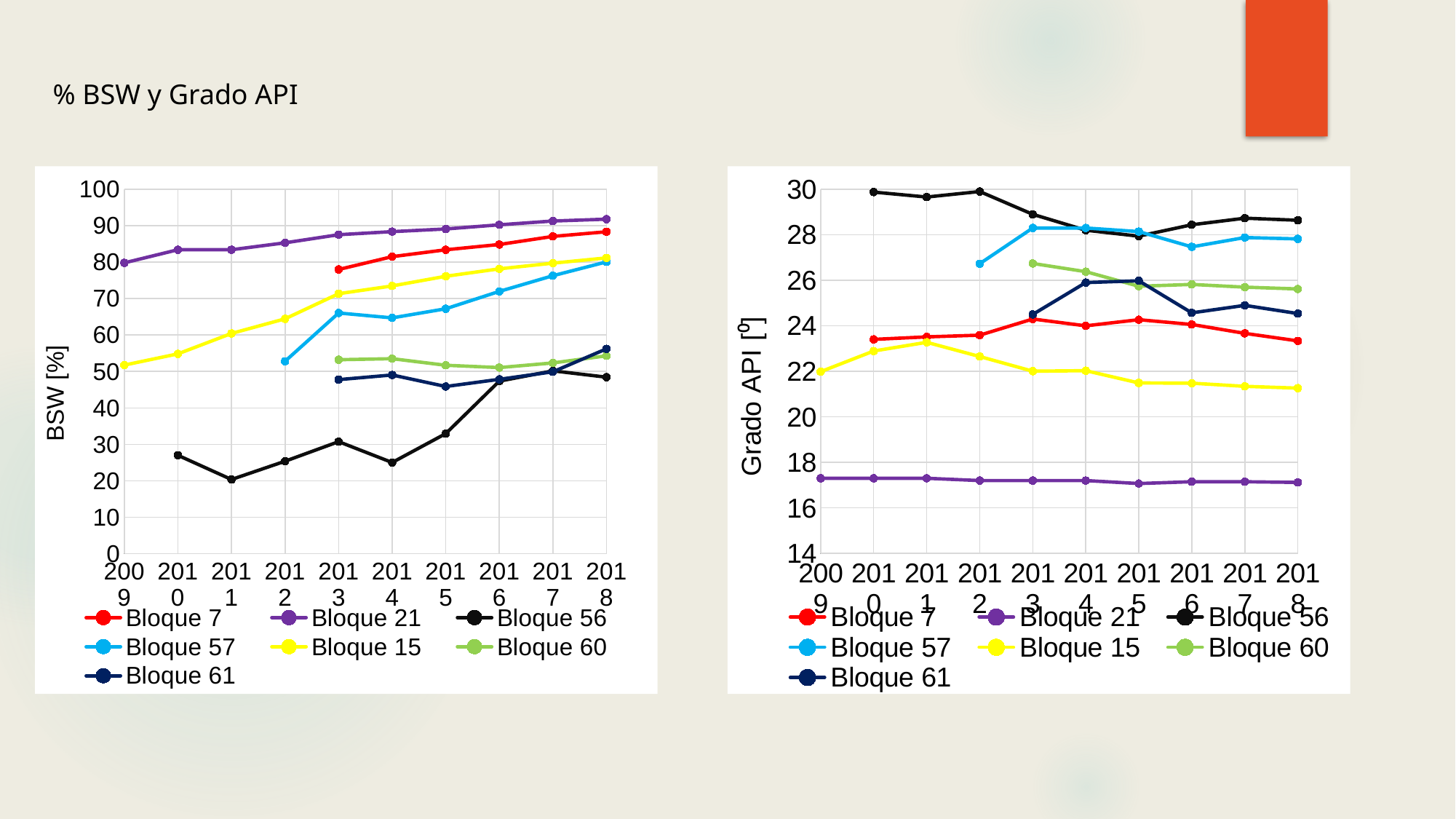
In the left chart (BSW [%]), is the value for Bloque 21 in 2018 greater or less than 90? greater In the left chart (BSW [%]), which series has the highest value in 2018? Bloque 21 In the left chart (BSW [%]), does the Bloque 21 line rise or fall from 2009 to 2018? rise In the left chart (BSW [%]), is the value for Bloque 56 in 2011 greater or less than 30? less How many years are shown on the x axis of the left chart (BSW [%])? 10 In the left chart (BSW [%]), which is larger in 2013: Bloque 57 or Bloque 15? Bloque 15 How many series does the legend of the right chart (Grado API) list? 7 What type of chart is the left chart (BSW [%])? line chart In the right chart (Grado API), which is larger in 2018: Bloque 7 or Bloque 61? Bloque 61 In the right chart (Grado API), which series has the lowest value in 2018? Bloque 21 In the left chart (BSW [%]), which series has the lowest value in 2011? Bloque 56